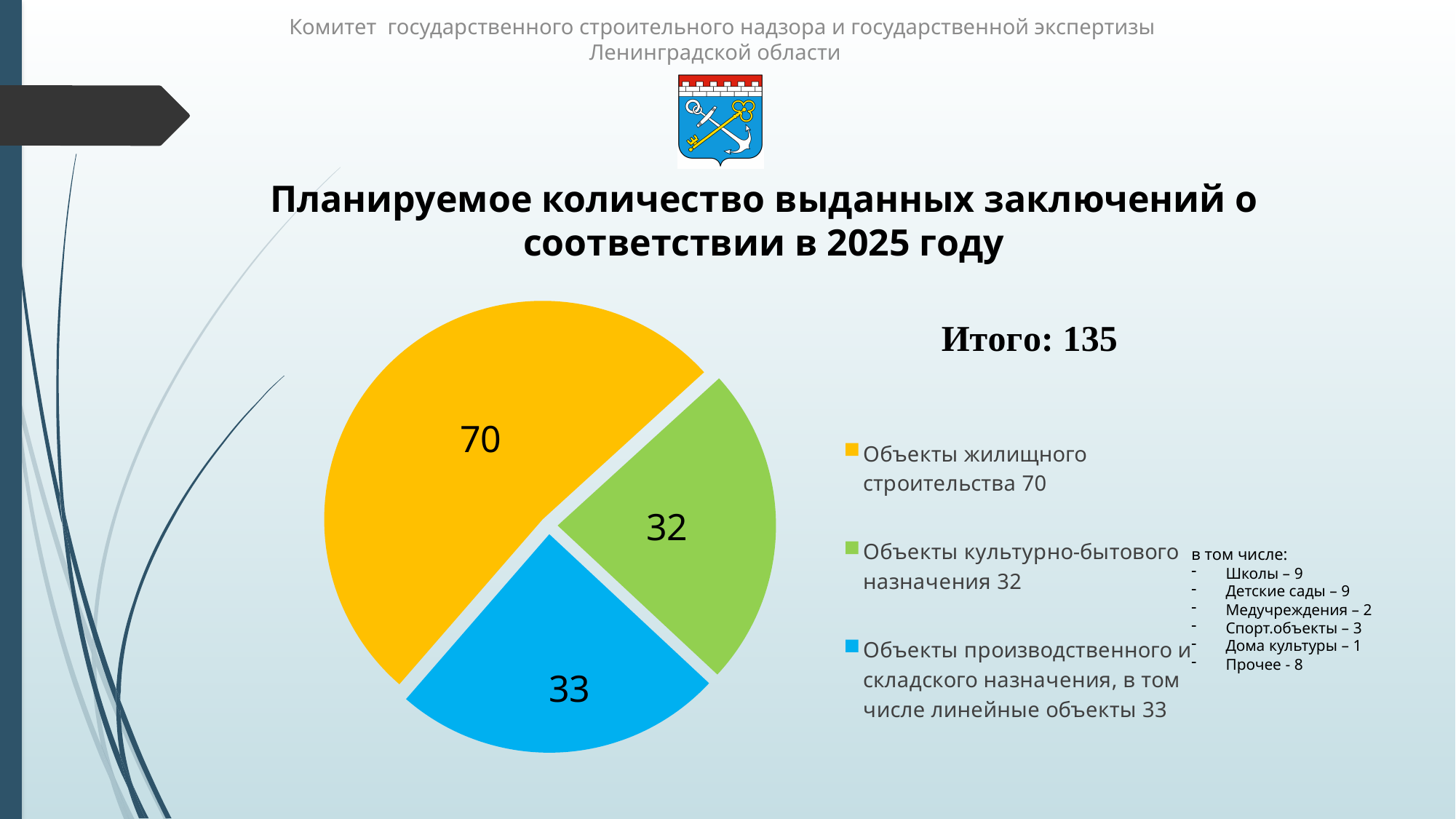
What is the value for Объекты производственного и складского назначения? 33 What is the difference between the values for Объекты производственного и складского назначения and Объекты культурно-бытового назначения? 1 Which category has the smallest slice of the pie? Объекты культурно-бытового назначения What colour is the slice for Объекты жилищного строительства? Yellow What is the difference between the values for Объекты жилищного строительства and Объекты производственного и складского назначения? 37 What is the total of all slices in the pie chart (Итого)? 135 What is the value for Объекты культурно-бытового назначения? 32 What is the value for Объекты жилищного строительства? 70 How many slices does the pie chart have? 3 Which category has the largest slice of the pie? Объекты жилищного строительства What kind of chart is shown on the slide? Pie chart Which is larger: the value for Объекты жилищного строительства or for Объекты культурно-бытового назначения? Объекты жилищного строительства